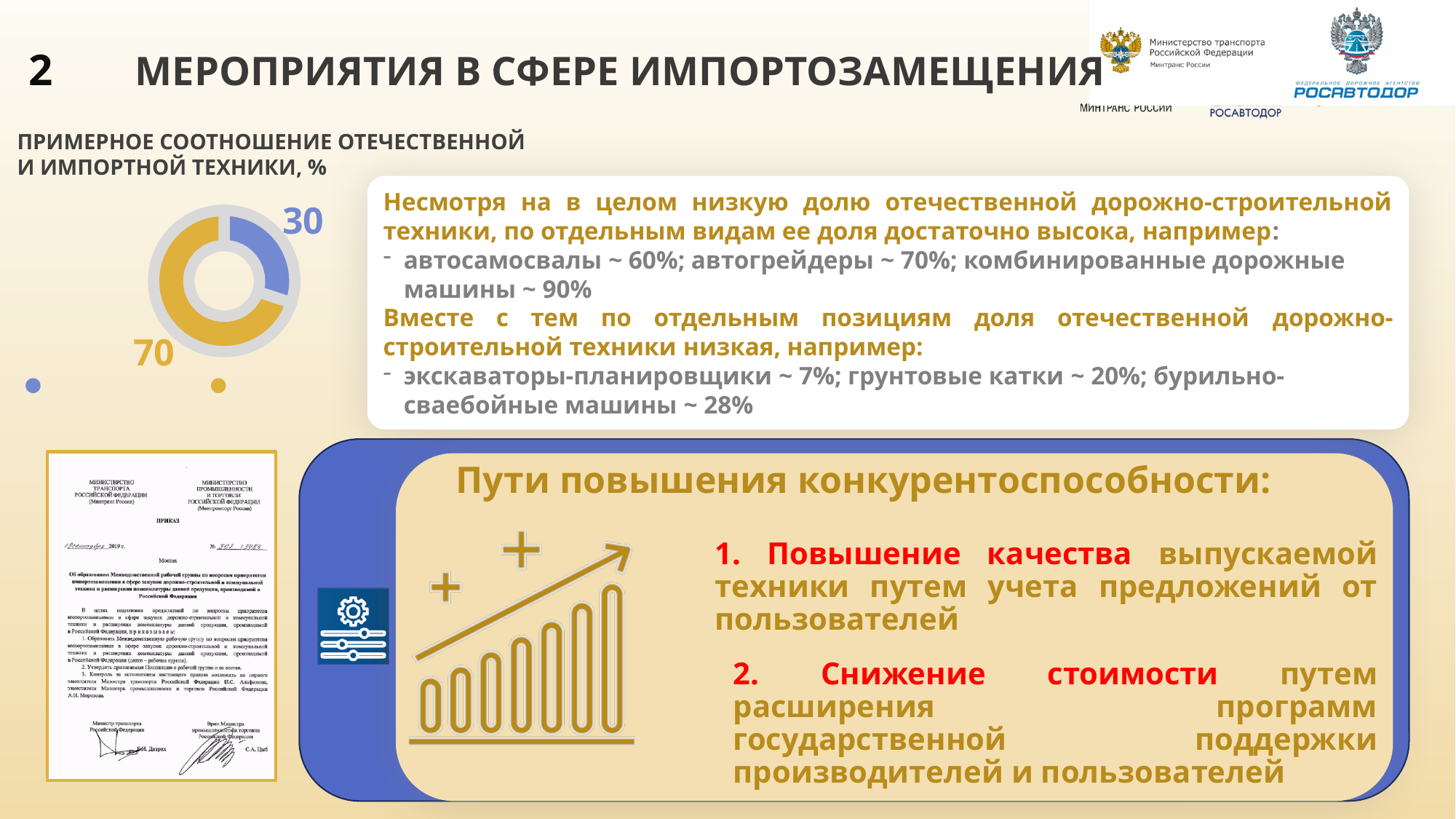
What is the title written above the donut chart? ПРИМЕРНОЕ СООТНОШЕНИЕ ОТЕЧЕСТВЕННОЙ И ИМПОРТНОЙ ТЕХНИКИ, % Which slice of the donut chart is larger, the gold one or the blue one? the gold one What two colours are used for the slices of the donut chart? gold and blue What is the largest value shown in the donut chart? 70 What do the two values in the donut chart add up to? 100 What value is labelled on the gold (larger) slice of the donut chart? 70 What kind of chart is shown under the heading 'ПРИМЕРНОЕ СООТНОШЕНИЕ ОТЕЧЕСТВЕННОЙ И ИМПОРТНОЙ ТЕХНИКИ, %'? pie (donut) chart What share of the whole does the gold slice of the donut chart represent? 70% What is the difference between the two values shown in the donut chart? 40 How many slices does the donut chart have? 2 What value is labelled on the blue (smaller) slice of the donut chart? 30 What is the smallest value shown in the donut chart? 30